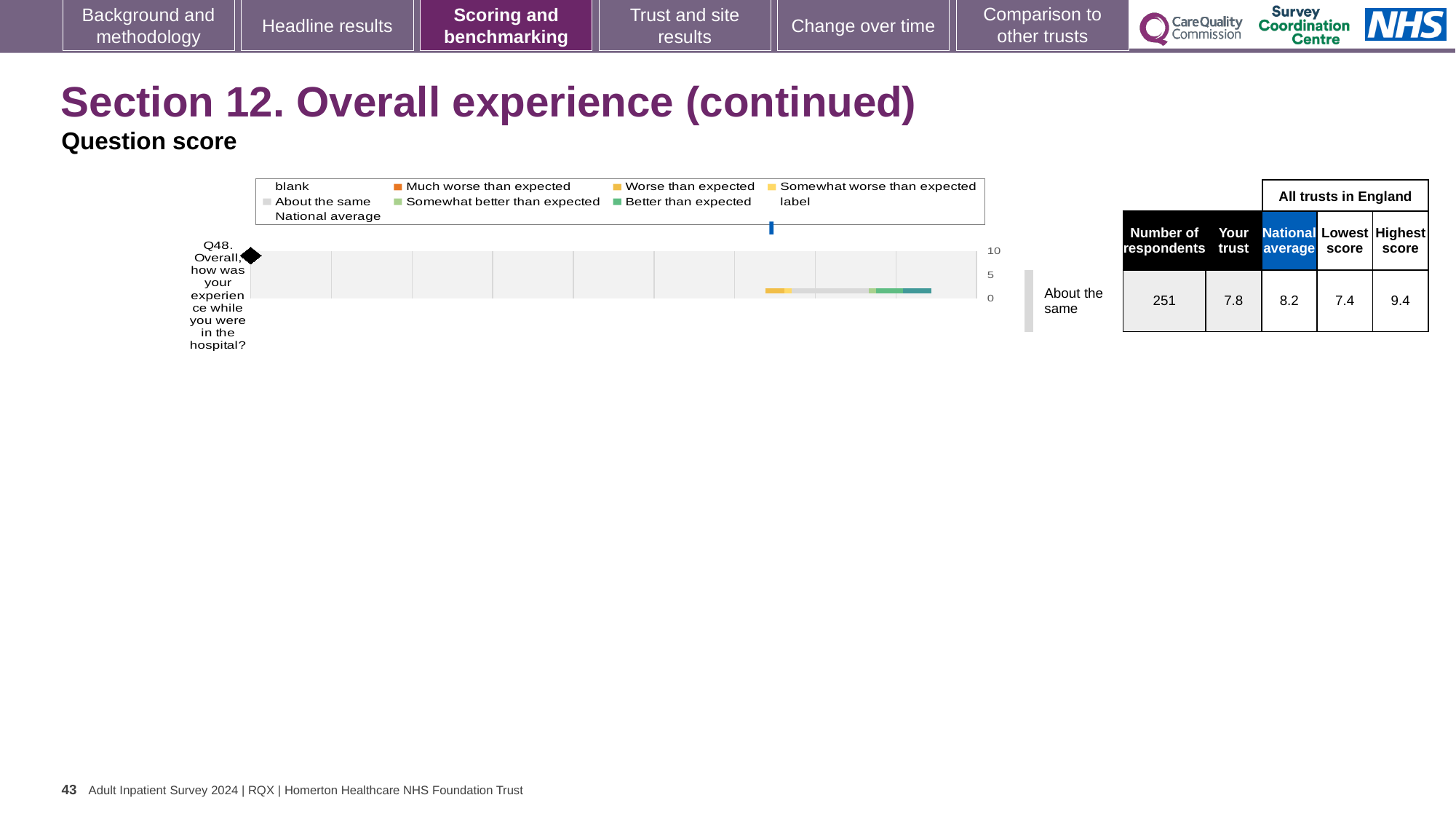
What is the National average score for Q48 shown next to the chart? 8.2 What is the Highest score among all trusts in England for Q48? 9.4 What is the difference between the Highest score and the Lowest score for Q48? 2.0 How many respondents answered Q48? 251 What benchmark category is the trust's Q48 score placed in? About the same What is the Lowest score among all trusts in England for Q48? 7.4 What kind of chart is shown on the slide? bar chart Which question is plotted on the chart? Q48. Overall, how was your experience while you were in the hospital? How many questions (categories) are plotted on the chart? 1 What is the 'Your trust' score for Q48 shown next to the chart? 7.8 What is the highest value shown on the chart's axis? 10 Which is larger for Q48, the 'Your trust' score or the National average? National average